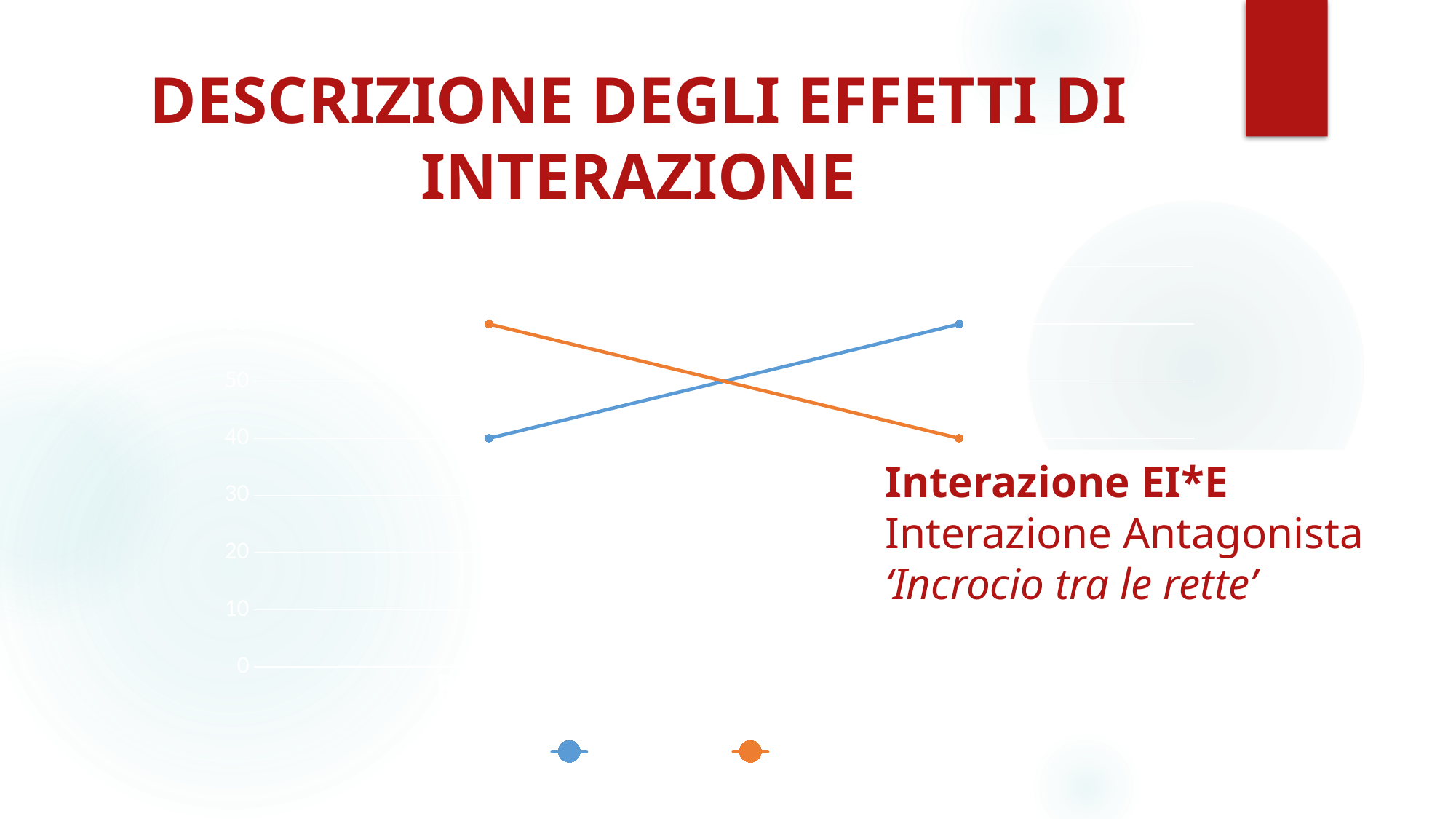
Does the blue line rise or fall from left to right? rise What colours are the two lines in the chart? blue and orange Does the orange line rise or fall from left to right? fall At the right-hand point, which line is higher, the blue or the orange? blue Is the value of the orange line's right-hand point greater or less than 50? less How many series does the legend list? 2 Is the value of the orange line's left-hand point greater or less than 50? greater At the left-hand point, which line is higher, the blue or the orange? orange What kind of chart is shown on the slide? line chart How many data points does the blue line have? 2 Is the value of the blue line's right-hand point greater or less than 50? greater What is the lowest value labelled on the vertical axis? 0